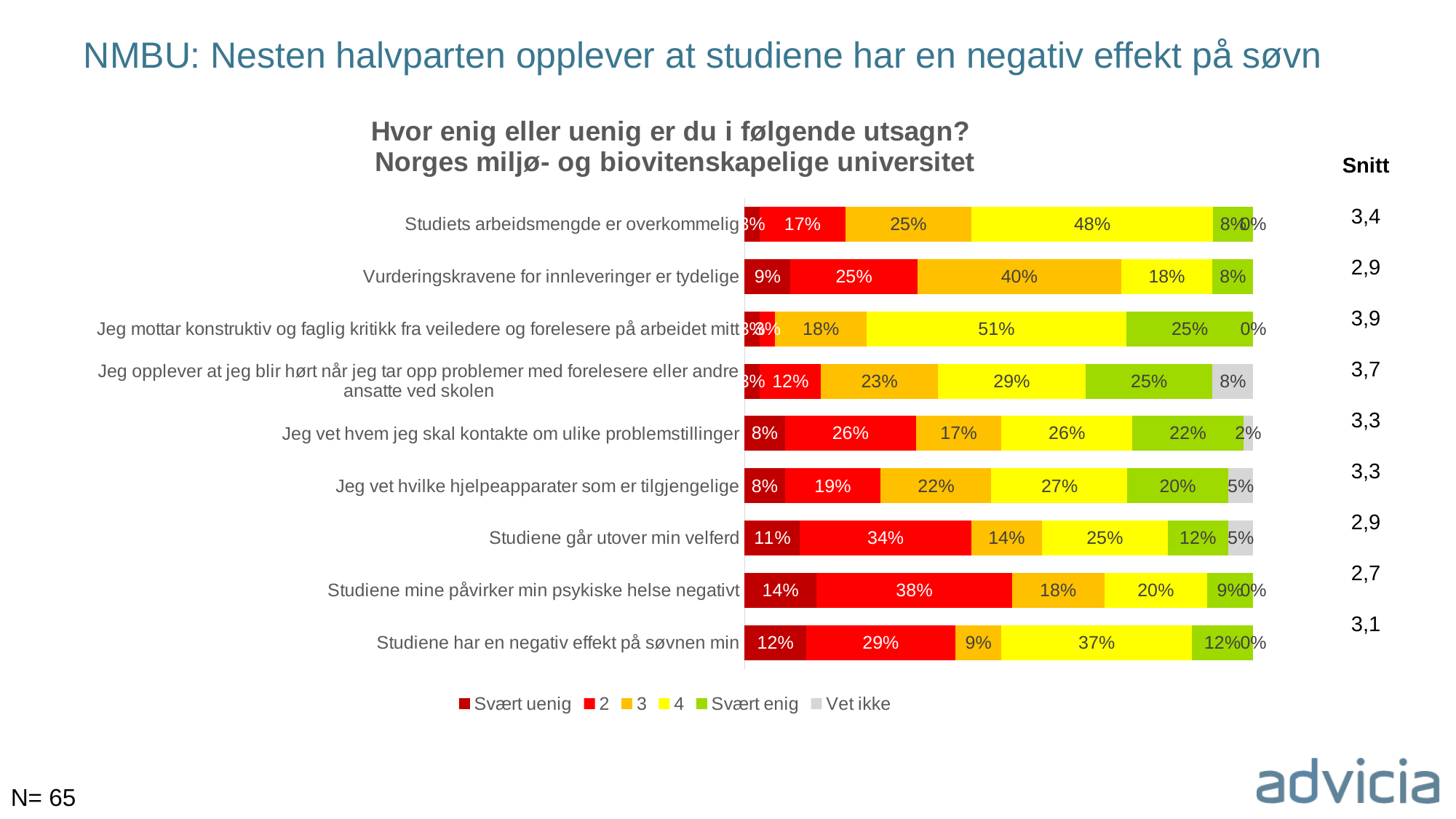
What is the sample size (N) shown on the slide? 65 What kind of chart is shown on the slide? Stacked bar chart What is the Snitt value for the statement "Studiene har en negativ effekt på søvnen min"? 3,1 How many statements (categories) are plotted in the chart? 9 What percentage answered "3" for the statement "Vurderingskravene for innleveringer er tydelige"? 40% Which statement has a larger "Svært enig" share: "Jeg vet hvem jeg skal kontakte om ulike problemstillinger" or "Jeg vet hvilke hjelpeapparater som er tilgjengelige"? Jeg vet hvem jeg skal kontakte om ulike problemstillinger What percentage answered "4" for the statement "Studiene har en negativ effekt på søvnen min"? 37% How many series does the legend list? 6 Which statement has the highest Snitt value? Jeg mottar konstruktiv og faglig kritikk fra veiledere og forelesere på arbeidet mitt (3,9) What percentage answered "2" for the statement "Studiene mine påvirker min psykiske helse negativt"? 38% Which statement has the lowest Snitt value? Studiene mine påvirker min psykiske helse negativt (2,7) For the statement "Studiene går utover min velferd", what is the difference between the "2" share and the "Svært uenig" share? 23 percentage points